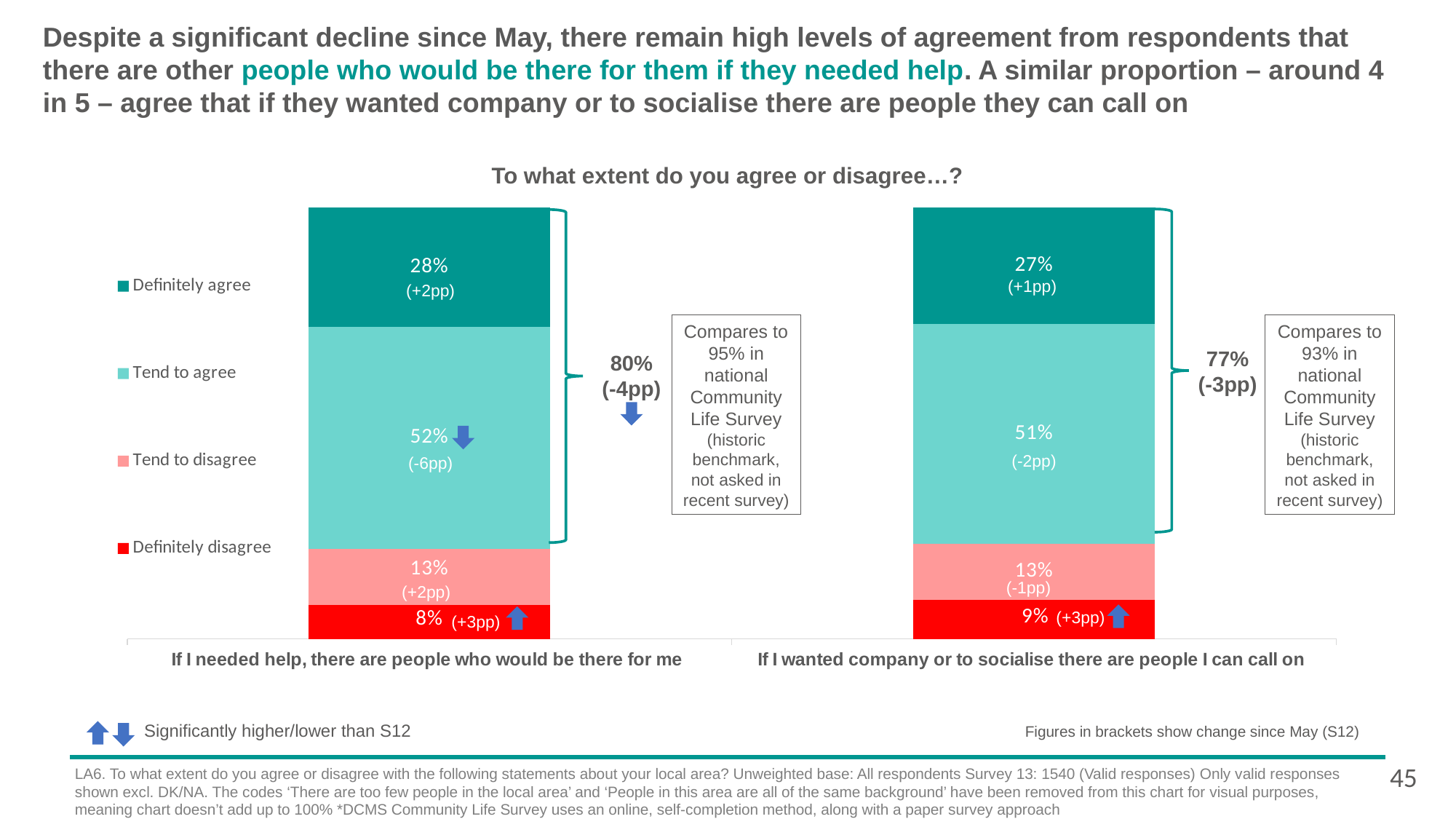
What percentage of respondents 'Tend to disagree' that if they wanted company or to socialise there are people they can call on? 13% How many response categories does the legend list? 4 What percentage of respondents 'Definitely agree' that if they needed help, there are people who would be there for them? 28% What percentage of respondents 'Definitely disagree' that if they wanted company or to socialise there are people they can call on? 9% What is the combined percentage of respondents who agree (definitely or tend to) that if they needed help, there are people who would be there for them? 80% What is the combined percentage of respondents who agree (definitely or tend to) that if they wanted company or to socialise there are people they can call on? 77% What type of chart is shown on the slide? Stacked bar chart What percentage of respondents 'Tend to agree' that if they needed help, there are people who would be there for them? 52% What is the difference between the 'Tend to agree' percentages for the two statements? 1% Which statement has the higher 'Definitely agree' percentage? If I needed help, there are people who would be there for me Which response category is the largest segment in the bar for 'If I needed help, there are people who would be there for me'? Tend to agree How many statements (bars) are shown in the chart? 2